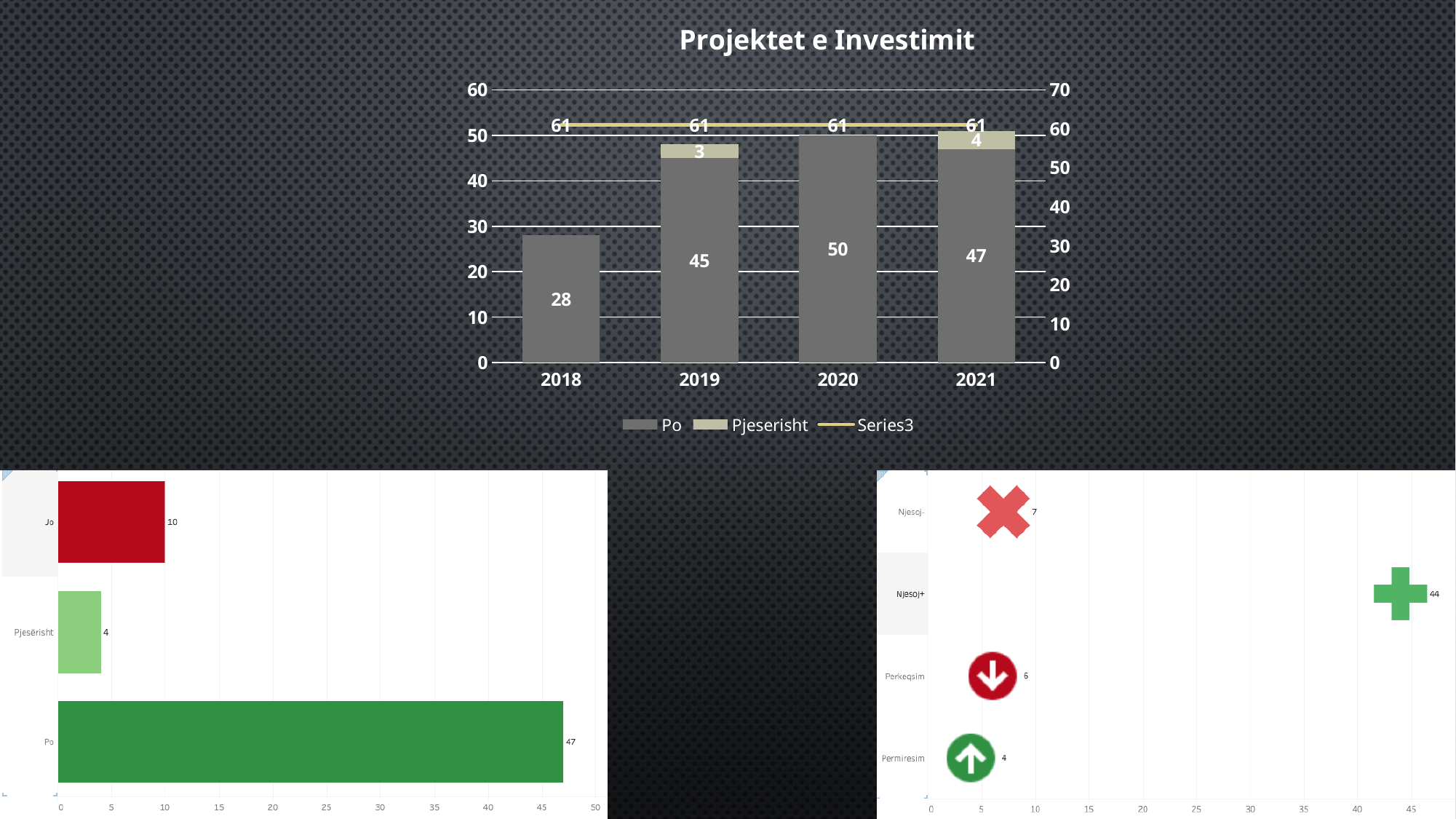
In the 'Projektet e Investimit' chart, what is the value of the Pjeserisht series for 2021? 4 In the 'Projektet e Investimit' chart, how many series does the legend list? 3 In the 'Projektet e Investimit' chart, what is the value of the Po series for 2020? 50 In the bottom-left chart, which category has the highest value? Po In the 'Projektet e Investimit' chart, what is the total of the stacked bar for 2019? 48 In the 'Projektet e Investimit' chart, what is the difference between the Po values for 2020 and 2018? 22 In the 'Projektet e Investimit' chart, which year has the lowest Po value? 2018 In the bottom-right chart, what is the value for Njesoj+? 44 In the bottom-left chart, what is the difference between the values for Po and Pjesërisht? 43 In the bottom-left chart, what is the value for Jo? 10 In the 'Projektet e Investimit' chart, what value does the Series3 line show for each year? 61 In the bottom-right chart, which is larger, the value for Perkeqsim or the value for Permiresim? Perkeqsim